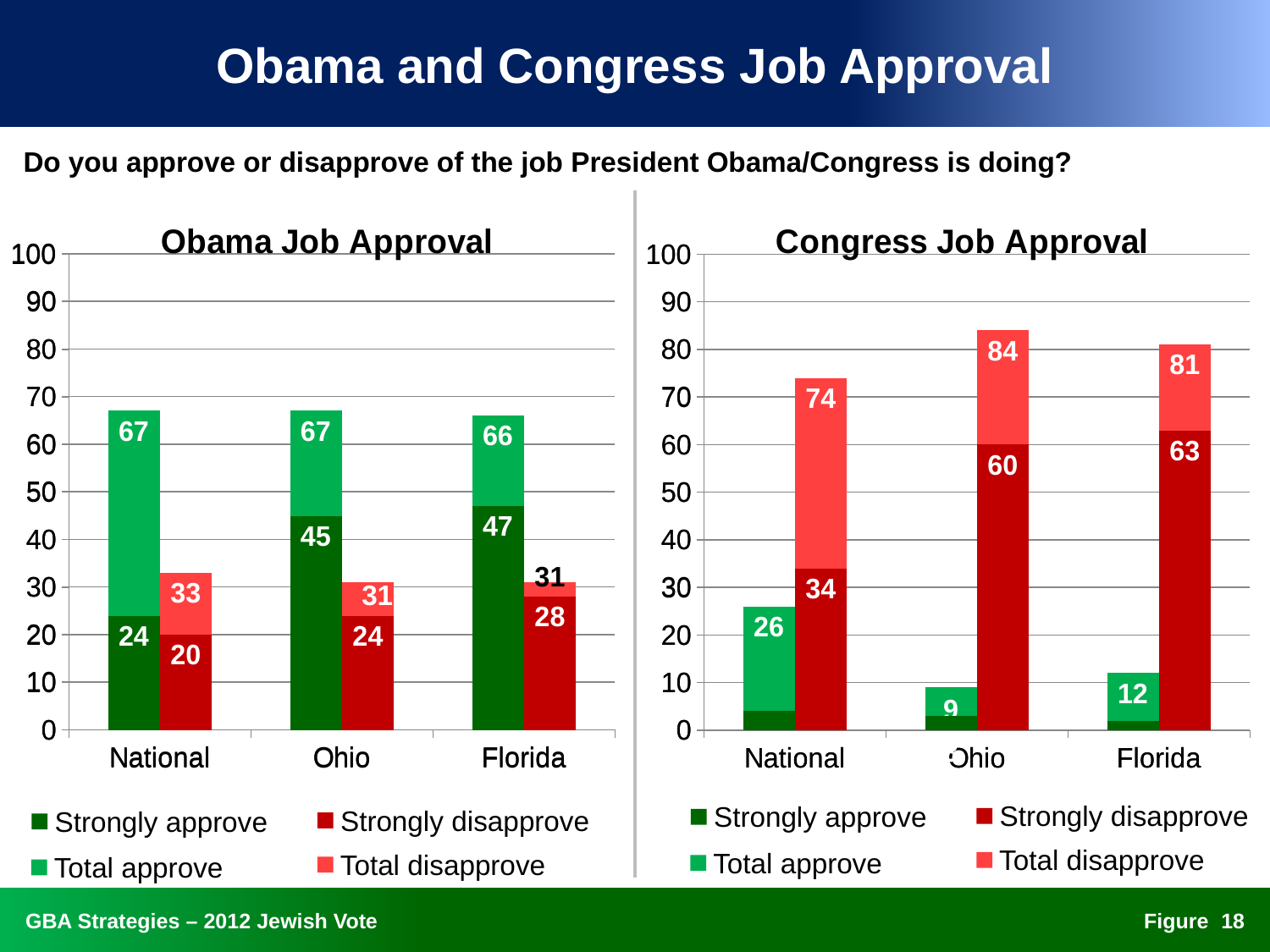
In the Congress Job Approval chart, which category has the highest Total disapprove value? Ohio How many series does the legend of the Congress Job Approval chart list? 4 In the Congress Job Approval chart, what is the Total disapprove value for Ohio? 84 In the Obama Job Approval chart, is the Strongly approve value larger for Ohio or Florida? Florida In the Obama Job Approval chart, what is the difference between Total approve and Total disapprove for Florida? 35 In the Congress Job Approval chart, which category has the lowest Total approve value? Ohio In the Congress Job Approval chart, what is the Strongly disapprove value for Florida? 63 How many categories are shown on the x axis of the Obama Job Approval chart? 3 In the Congress Job Approval chart, what is the difference between Total disapprove and Strongly disapprove for Ohio? 24 What kind of chart is the Obama Job Approval chart? bar chart In the Obama Job Approval chart, what is the Total approve value for National? 67 In the Congress Job Approval chart, is the Strongly approve value for National greater or less than 10? less